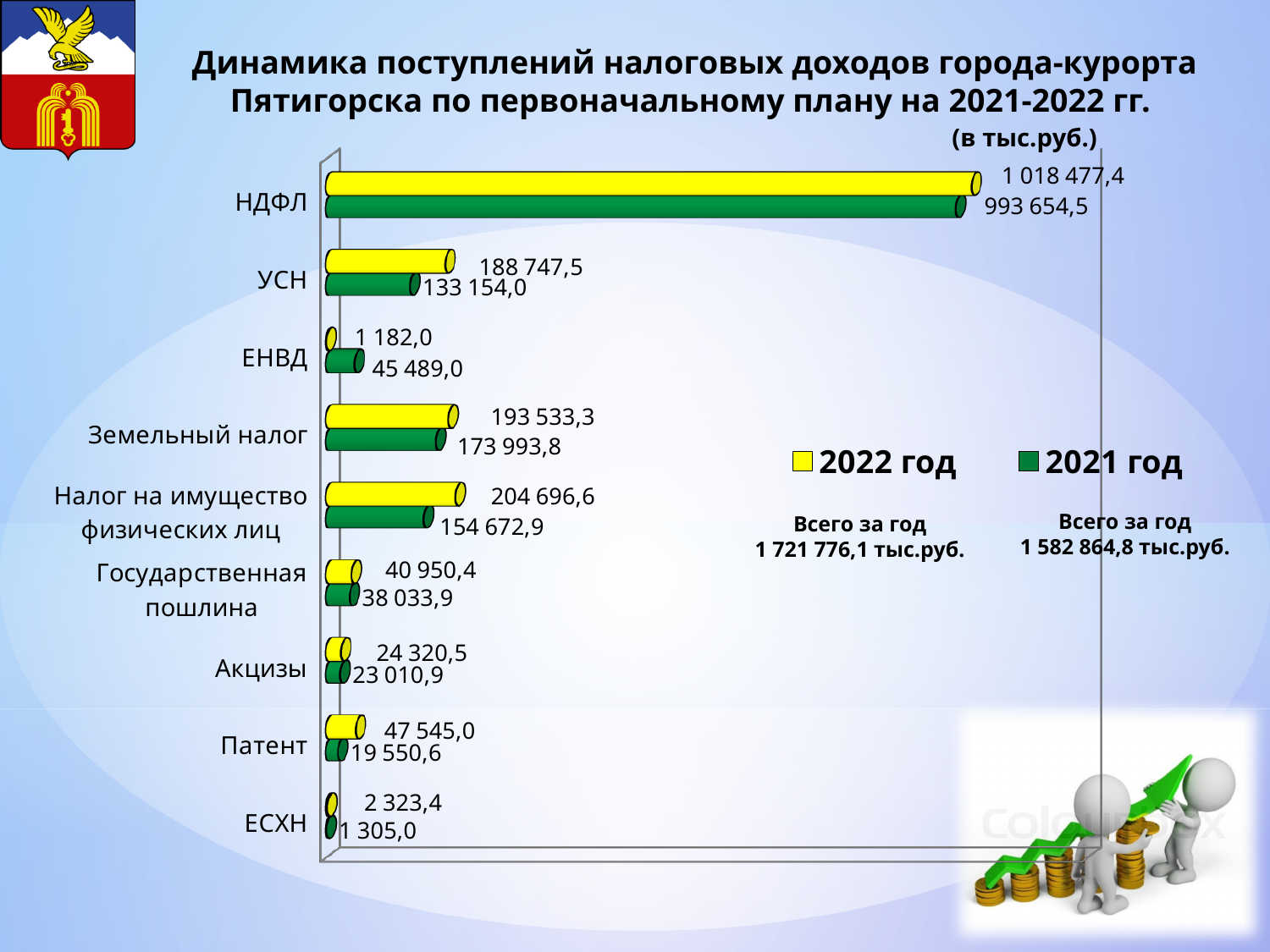
What kind of chart is shown on the slide? Bar chart What is the value for Патент in the 2022 год series? 47 545,0 Which category has the highest value in the 2021 год series? НДФЛ For ЕНВД, which series has the larger value, 2022 год or 2021 год? 2021 год What is the difference between the 2022 год and 2021 год values for НДФЛ? 24 822,9 Which colour represents the 2022 год series in the legend? Yellow How many tax categories are plotted on the chart? 9 Which category has the lowest value in the 2022 год series? ЕНВД What is the difference between the 2022 год and 2021 год values for Патент? 27 994,4 What is the value for УСН in the 2021 год series? 133 154,0 What is the value for НДФЛ in the 2022 год series? 1 018 477,4 How many series does the legend list? 2